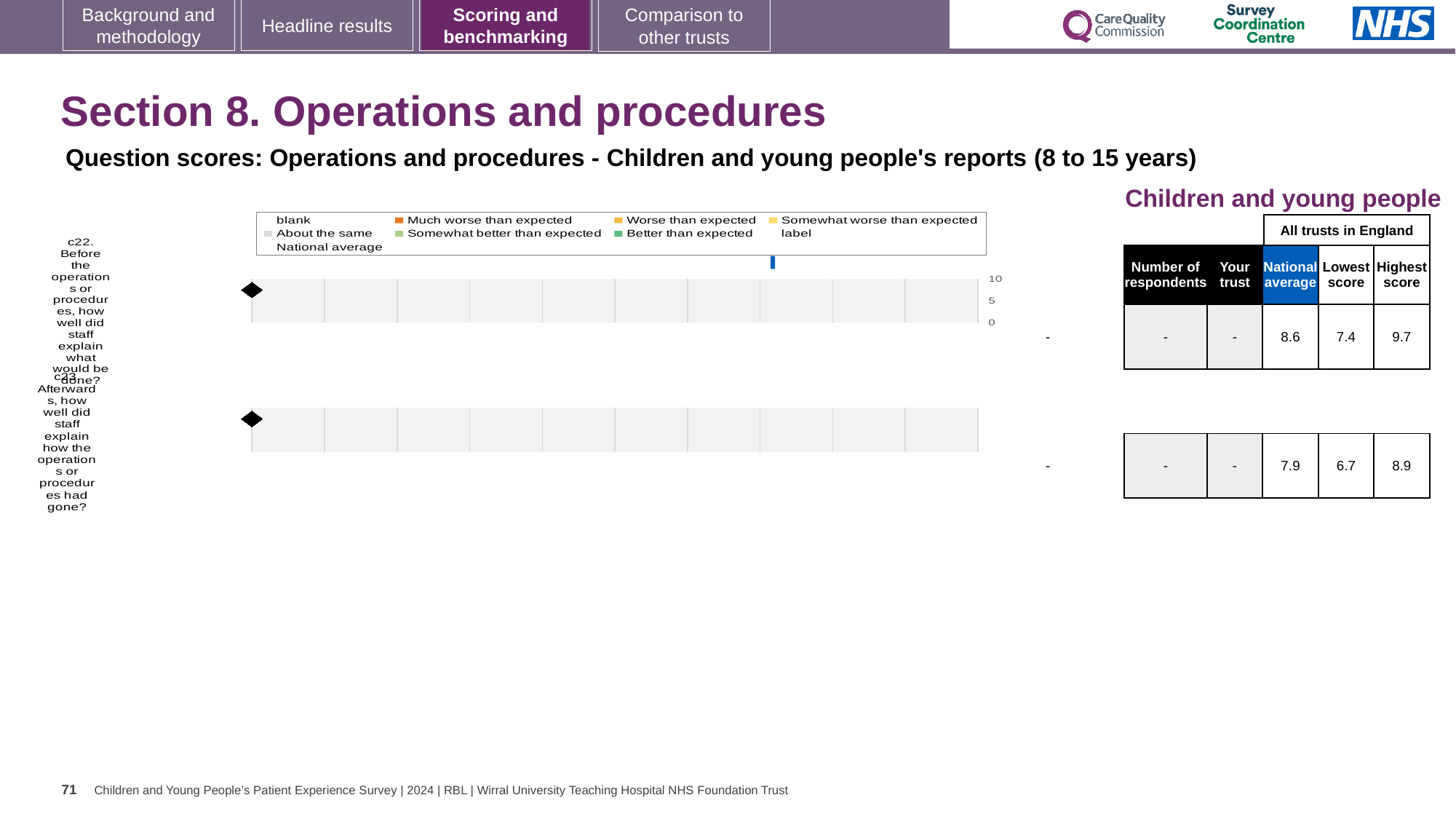
How many entries does the chart legend list? 9 In the table, what is the national average for c22 (Before the operations or procedures, how well did staff explain what would be done?)? 8.6 What kind of chart is shown on the slide? bar chart In the table, what is the difference between the highest and lowest score for c22? 2.3 How many question categories are plotted on the chart? 2 What is the highest value shown on the chart's axis? 10 In the table, what is the highest score for c23? 8.9 In the table, what is the lowest score for c22? 7.4 In the table, what is the difference between the national averages of c22 and c23? 0.7 In the table, which question has the higher national average, c22 or c23? c22 Which legend entry is shown with an orange marker? Much worse than expected In the table, what is the national average for c23 (Afterwards, how well did staff explain how the operations or procedures had gone?)? 7.9